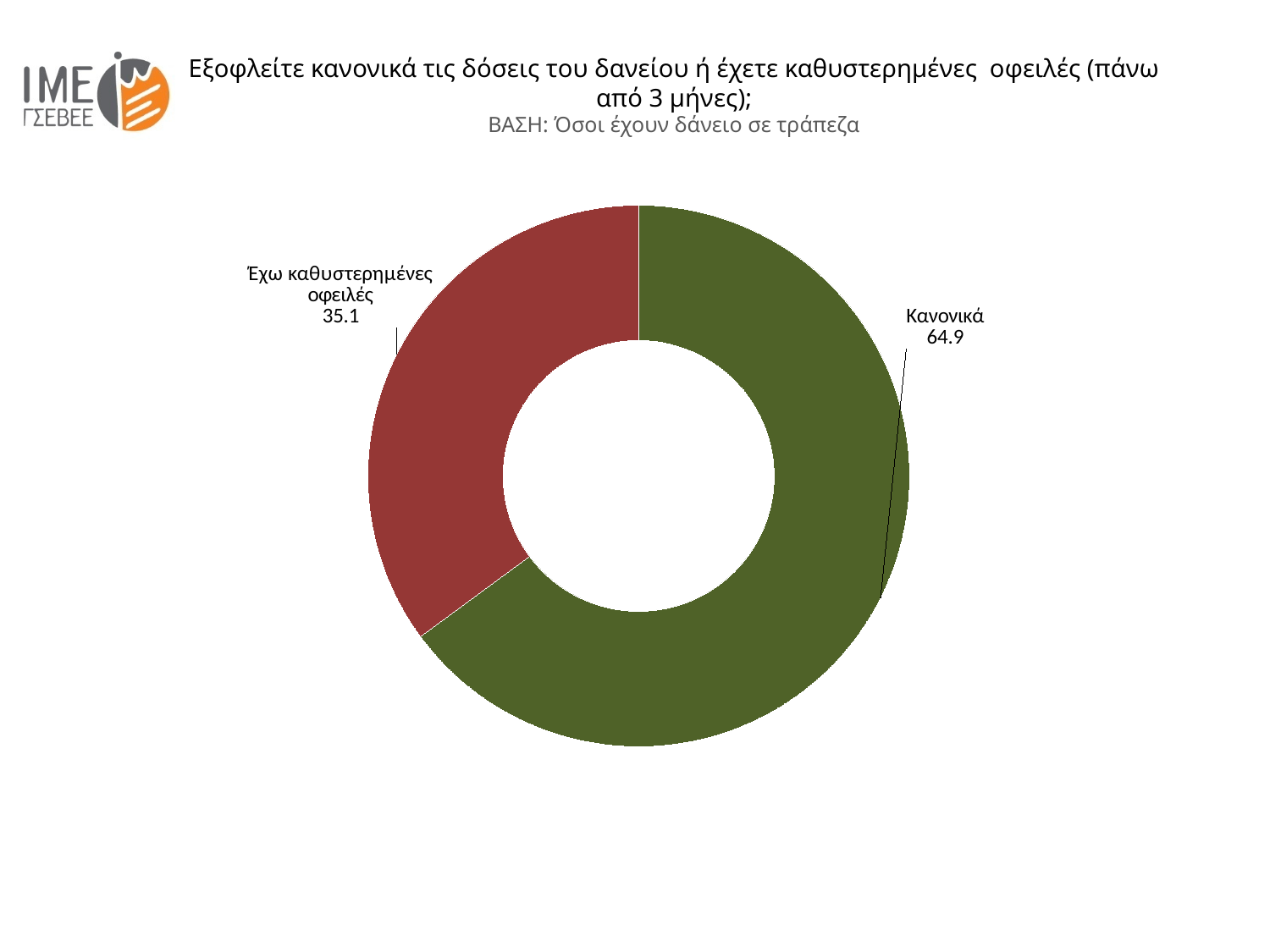
What is the total of the two values shown in the chart? 100 What kind of chart is shown on the slide? Doughnut (pie) chart What is the value for Έχω καθυστερημένες οφειλές? 35.1 What is the difference between the values for Κανονικά and Έχω καθυστερημένες οφειλές? 29.8 Which is larger, the value for Κανονικά or the value for Έχω καθυστερημένες οφειλές? Κανονικά Which category has the lowest value? Έχω καθυστερημένες οφειλές What colour is the Έχω καθυστερημένες οφειλές slice? Red What is the value for Κανονικά? 64.9 Which category has the highest value? Κανονικά What colour is the Κανονικά slice? Green How many categories are shown in the chart? 2